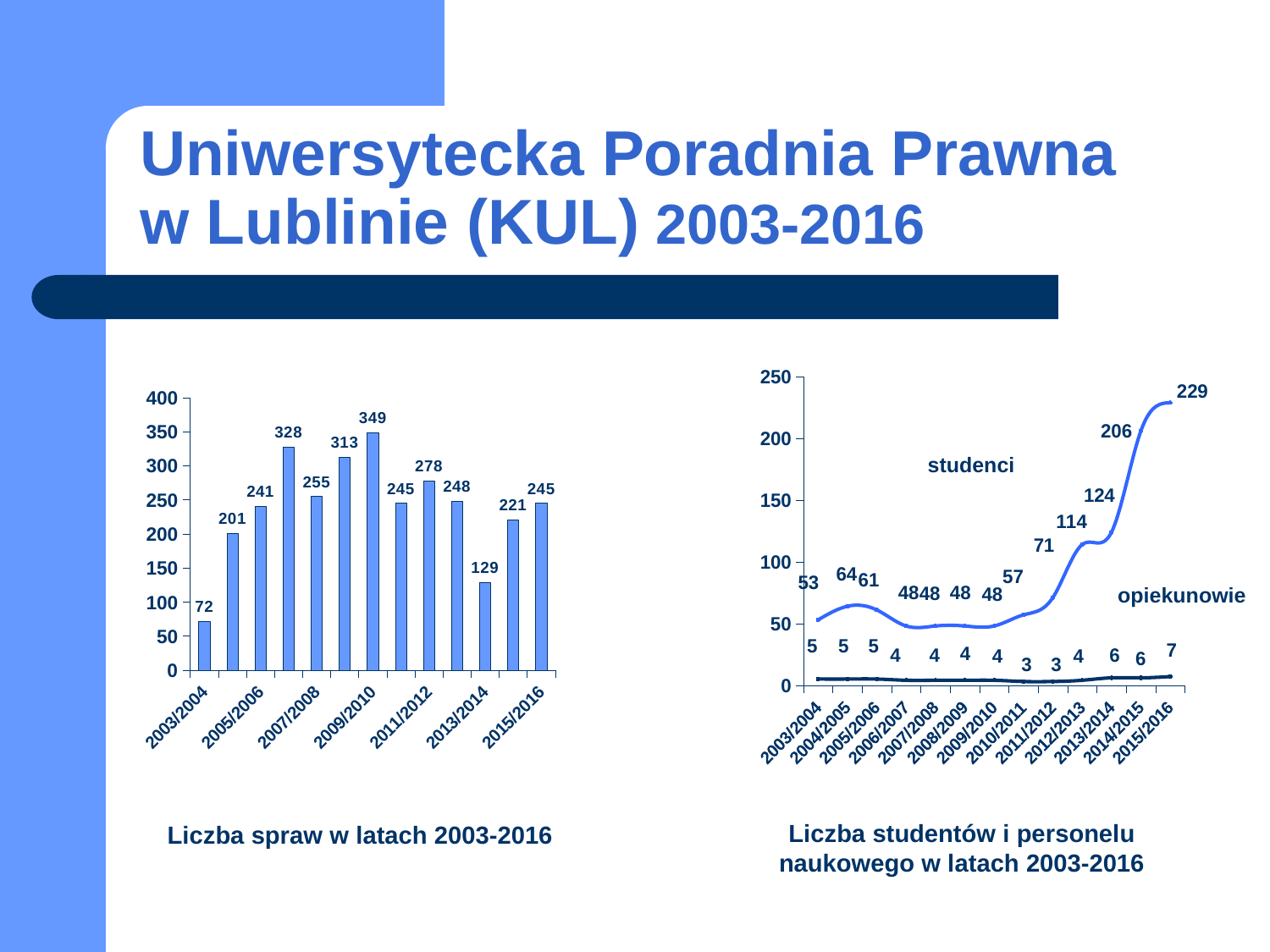
In the left chart 'Liczba spraw w latach 2003-2016', what is the value for 2003/2004? 72 In the right chart 'Liczba studentów i personelu naukowego w latach 2003-2016', does the 'studenci' series rise or fall between 2012/2013 and 2015/2016? rise How many bars are plotted in the left chart 'Liczba spraw w latach 2003-2016'? 13 How many series are plotted in the right chart 'Liczba studentów i personelu naukowego w latach 2003-2016'? 2 In the right chart 'Liczba studentów i personelu naukowego w latach 2003-2016', what is the value of the 'opiekunowie' series for 2003/2004? 5 In the right chart 'Liczba studentów i personelu naukowego w latach 2003-2016', what is the value of the 'studenci' series for 2015/2016? 229 In the left chart 'Liczba spraw w latach 2003-2016', which year has the lowest value? 2003/2004 In the left chart 'Liczba spraw w latach 2003-2016', what is the value for 2013/2014? 129 What kind of chart is the left chart, 'Liczba spraw w latach 2003-2016'? bar chart In the left chart 'Liczba spraw w latach 2003-2016', which year has the highest value? 2009/2010 In the left chart 'Liczba spraw w latach 2003-2016', what is the difference between the values for 2009/2010 and 2015/2016? 104 In the left chart 'Liczba spraw w latach 2003-2016', which is larger: the value for 2007/2008 or the value for 2011/2012? 2011/2012